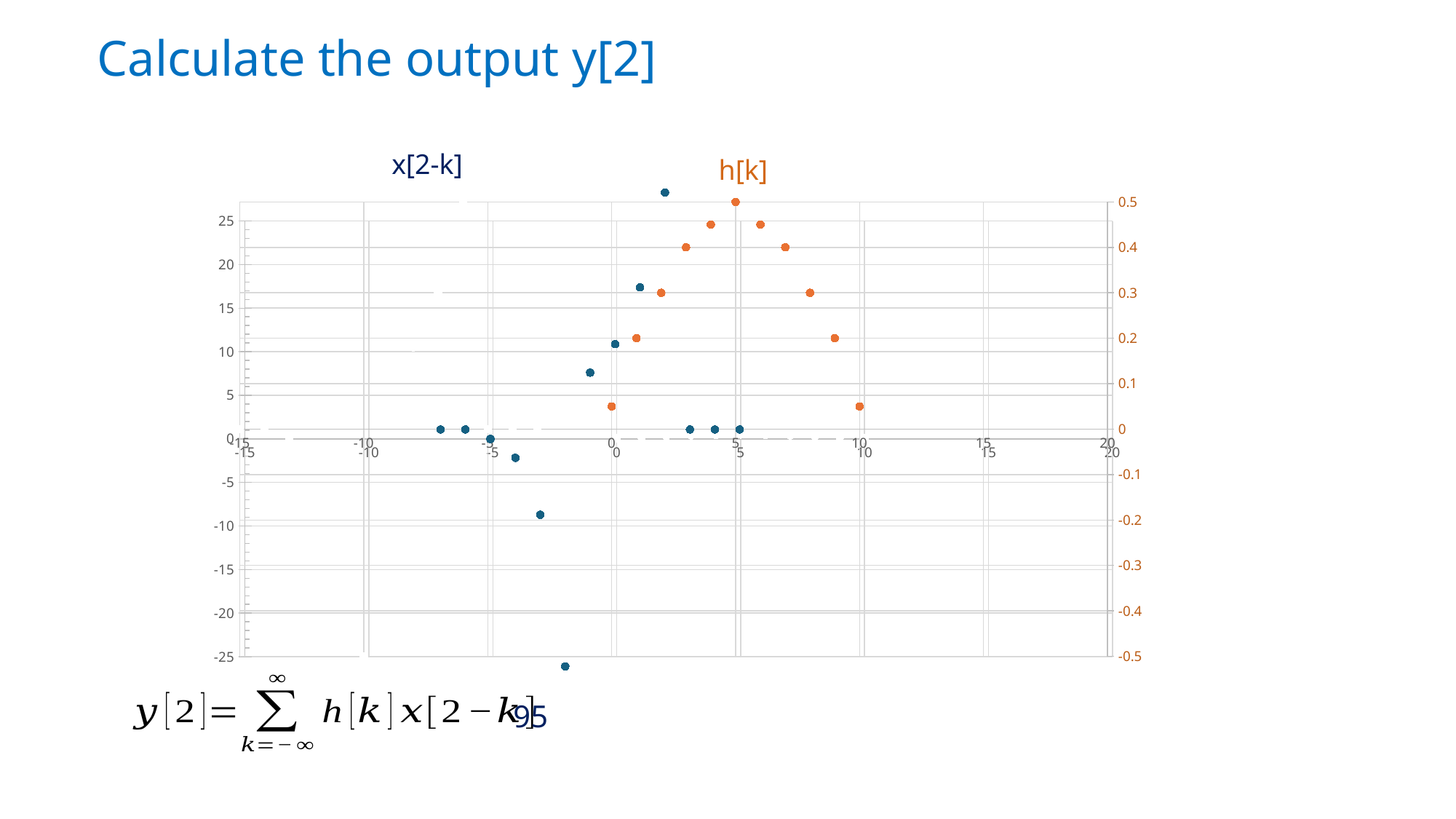
At which value of k does the x[2-k] series reach its highest point? 2 Which is larger, h[k] at k=3 or h[k] at k=1? h[k] at k=3 How many points are plotted for the x[2-k] series? 13 What kind of chart is shown on the slide? scatter chart How many series are plotted on the chart? 2 Which colour is used for the h[k] series? orange At which value of k does the h[k] series reach its highest point? 5 How many points are plotted for the h[k] series? 11 What are the names of the two series plotted on the chart? x[2-k] and h[k] At which value of k does the x[2-k] series reach its lowest point? -2